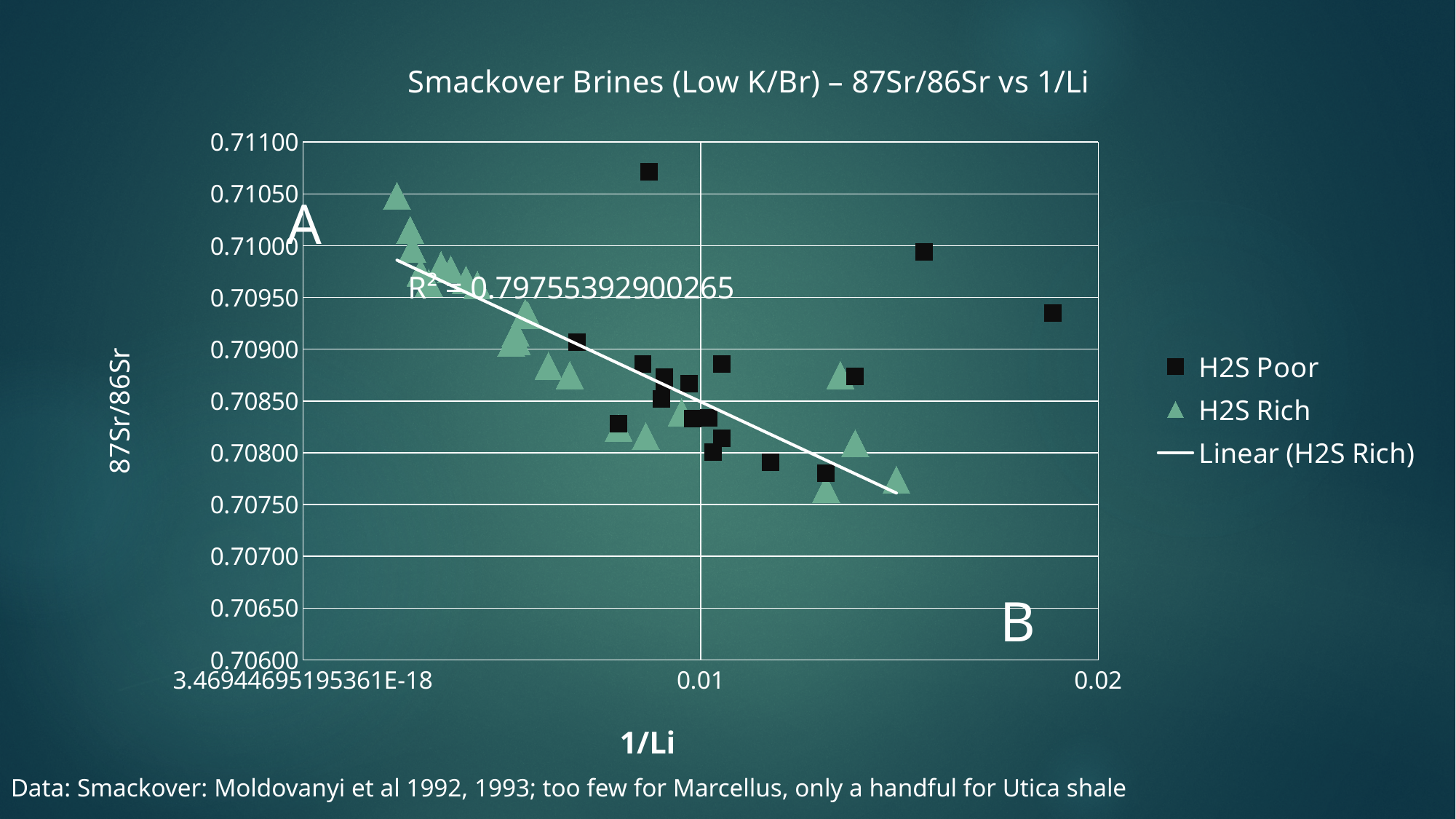
Which series contains the single highest 87Sr/86Sr point on the chart, H2S Poor or H2S Rich? H2S Poor Is the H2S Poor point at the far right of the chart (near 1/Li = 0.02) greater or less than 0.70900 on the 87Sr/86Sr axis? greater Do the H2S Rich values rise or fall as 1/Li increases along the x axis? Fall Is the lowest H2S Poor point greater or less than 0.70800 on the 87Sr/86Sr axis? less What kind of chart is shown on the slide? Scatter chart What is the label of the x axis? 1/Li Is the highest H2S Poor point greater or less than 0.71050 on the 87Sr/86Sr axis? greater Which series is the linear trendline fitted to, according to the legend? H2S Rich How many series does the legend list? 3 What is the title of the chart? Smackover Brines (Low K/Br) – 87Sr/86Sr vs 1/Li What R² value is printed on the chart for the linear trendline? 0.79755392900265